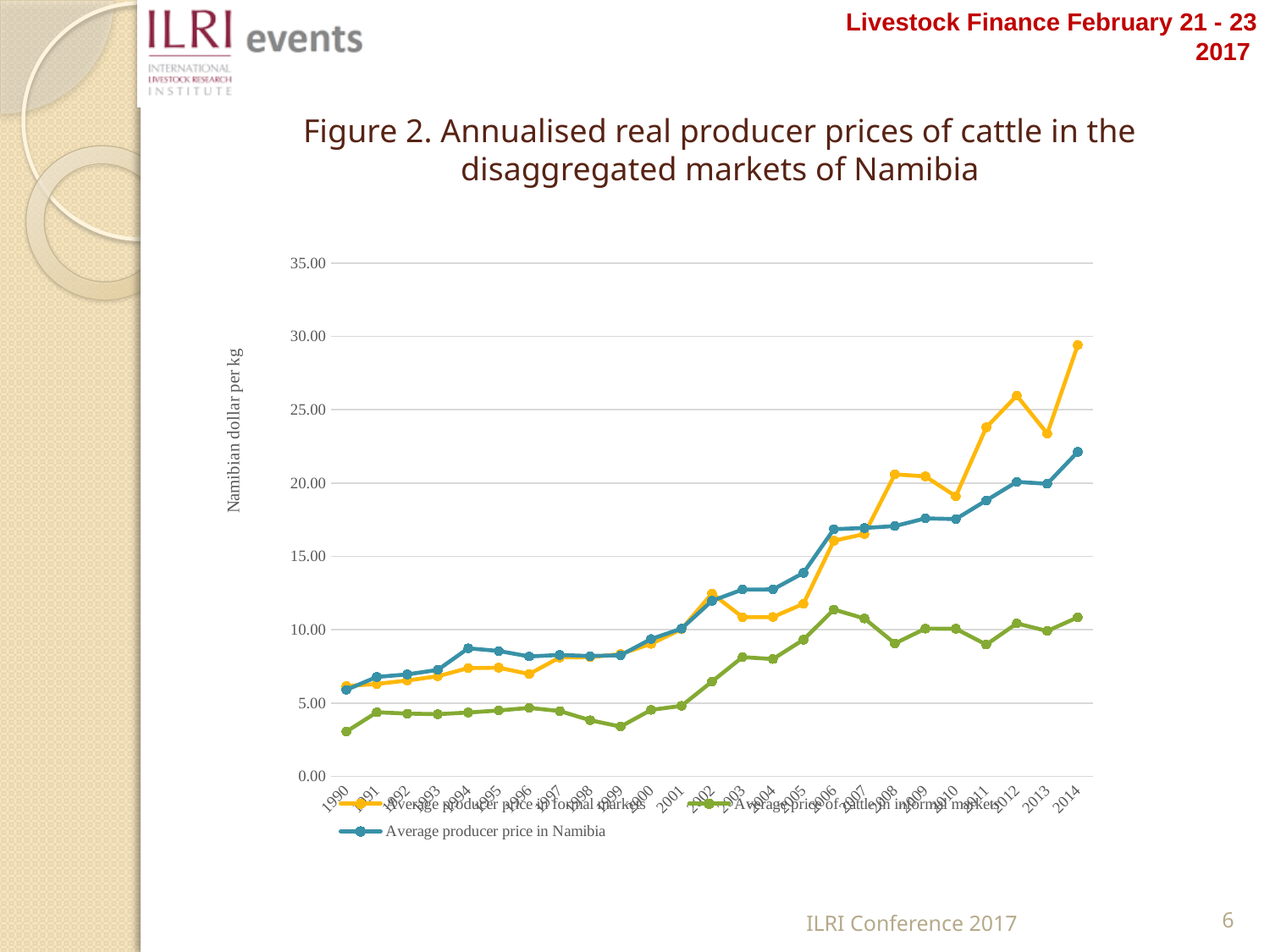
Overall, does the average producer price in formal markets rise or fall from 1990 to 2014? Rise Is the average producer price in Namibia in 2014 greater or less than 20.00? greater Is the average price of cattle in informal markets in 1999 greater or less than 5.00? less What is the title of the chart? Figure 2. Annualised real producer prices of cattle in the disaggregated markets of Namibia In 2014, which is larger: the average producer price in formal markets or the average price of cattle in informal markets? Average producer price in formal markets How many series does the legend list? 3 What is the label on the y axis? Namibian dollar per kg What kind of chart is shown on the slide? Line chart How many years are plotted along the x axis? 25 In which year is the average producer price in formal markets highest? 2014 Is the average price of cattle in informal markets in 2014 greater or less than 15.00? less